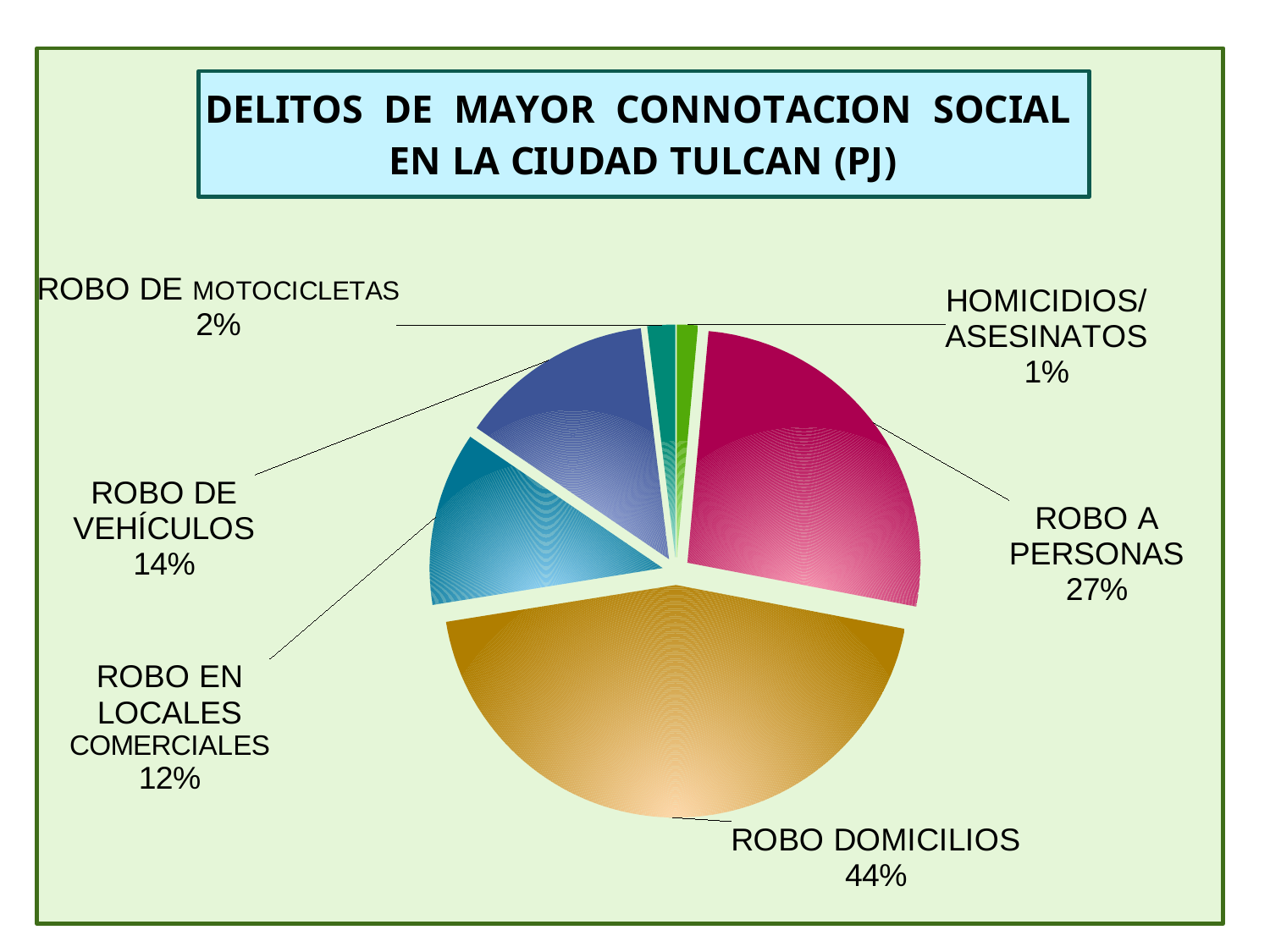
What is the value shown for HOMICIDIOS/ASESINATOS? 1% How many categories are shown in the pie chart? 6 Which is larger, the share for ROBO DE VEHÍCULOS or the share for ROBO EN LOCALES COMERCIALES? ROBO DE VEHÍCULOS What is the value shown for ROBO DE VEHÍCULOS? 14% What share of the pie does ROBO A PERSONAS represent? 27% What is the value shown for ROBO EN LOCALES COMERCIALES? 12% What is the value shown for ROBO DE MOTOCICLETAS? 2% Which category has the smallest slice of the pie? HOMICIDIOS/ASESINATOS What kind of chart is shown on the slide? pie chart What is the difference between the shares of ROBO DOMICILIOS and ROBO A PERSONAS? 17% What share of the pie does ROBO DOMICILIOS represent? 44% Which category has the largest slice of the pie? ROBO DOMICILIOS